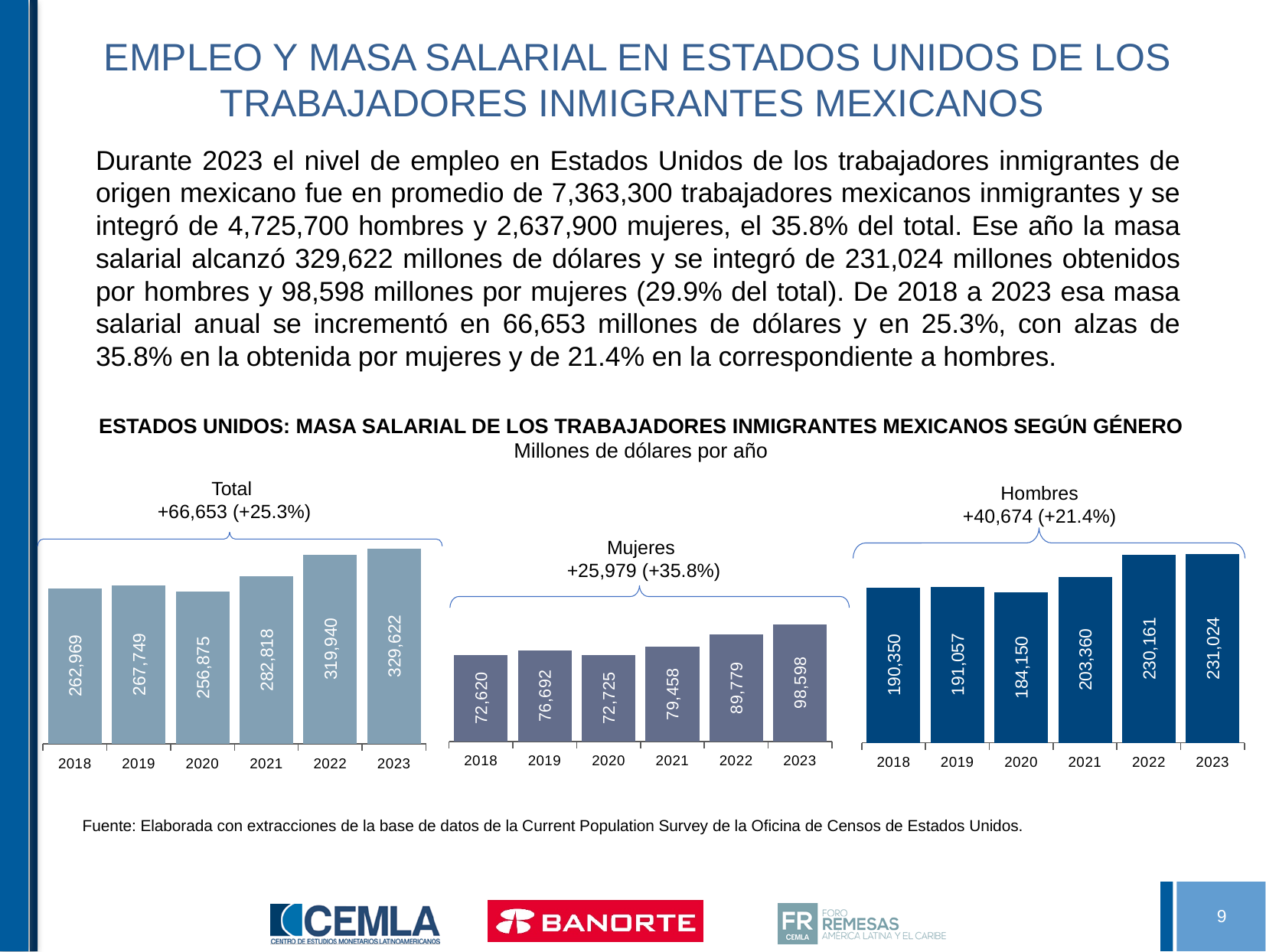
In the Total chart, which year has the lowest value? 2020 In the Mujeres chart, what is the difference between the 2023 value and the 2022 value? 8,819 In the Mujeres chart, which year has the highest value? 2023 In the Hombres chart, what is the value for 2021? 203,360 In the Mujeres chart, what is the value for 2022? 89,779 In the Total chart, what is the value for 2020? 256,875 How many years are shown in the Mujeres chart? 6 In the Total chart, do the values rise or fall from 2020 to 2023? rise In the Total chart, what is the difference between the 2023 value and the 2018 value? 66,653 In the Hombres chart, which is larger, the value for 2019 or the value for 2020? 2019 In the Hombres chart, which year has the lowest value? 2020 What kind of chart is the Hombres chart? bar chart